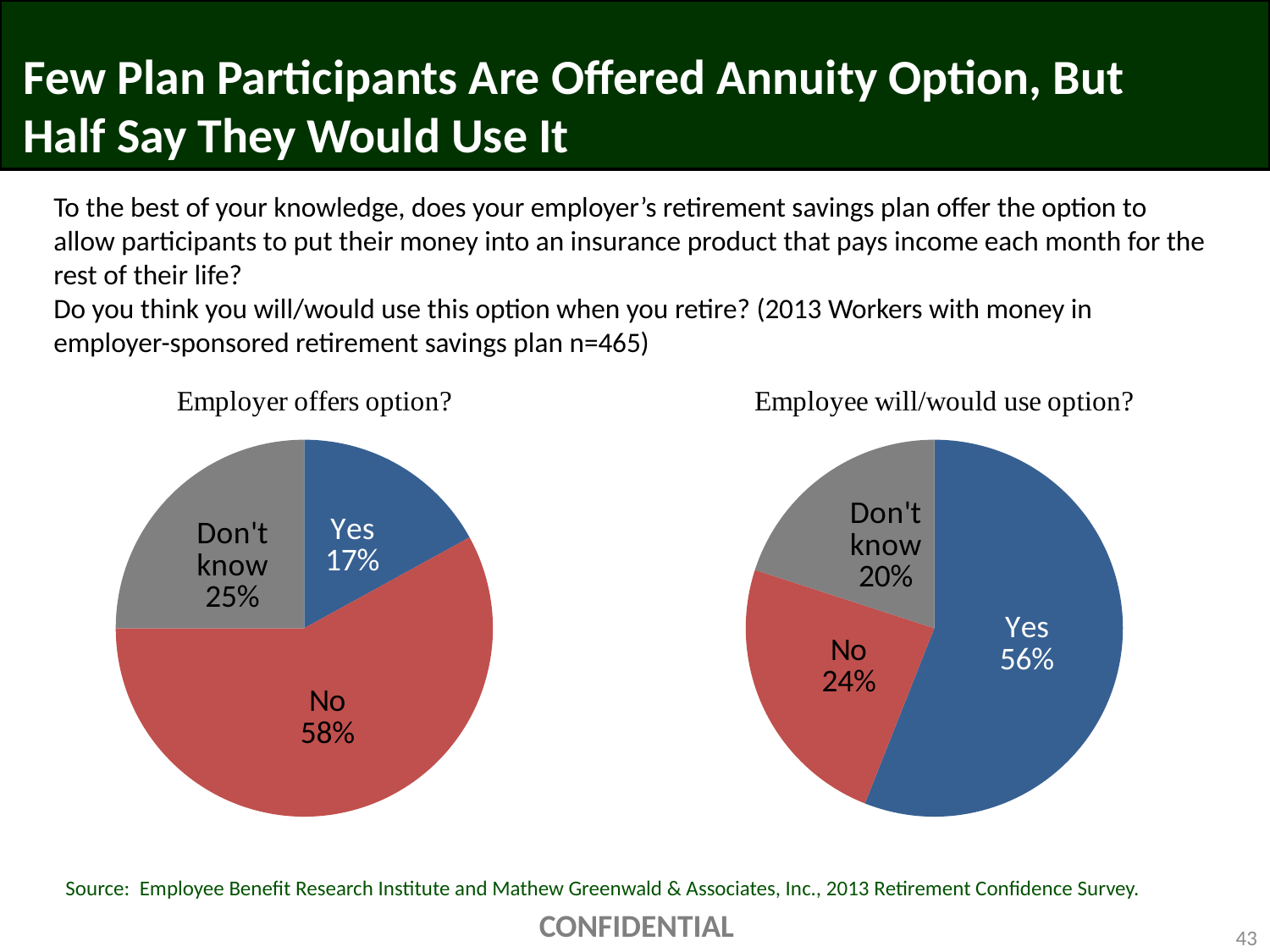
In the "Employer offers option?" chart, which response has the largest share? No In the "Employee will/would use option?" chart, which response has the smallest share? Don't know In the "Employee will/would use option?" chart, what percentage answered Don't know? 20% What colour is the No slice in the "Employer offers option?" chart? Red In the "Employee will/would use option?" chart, what percentage answered Yes? 56% In the "Employer offers option?" chart, what is the difference between the No and Yes shares? 41% In the "Employee will/would use option?" chart, what is the difference between the Yes and No shares? 32% Which is larger: the Don't know share in the "Employer offers option?" chart or the Don't know share in the "Employee will/would use option?" chart? Employer offers option? In the "Employer offers option?" chart, what percentage answered Yes? 17% In the "Employer offers option?" chart, what percentage answered No? 58% How many slices does the "Employer offers option?" chart have? 3 What type of chart is used for "Employee will/would use option?"? Pie chart